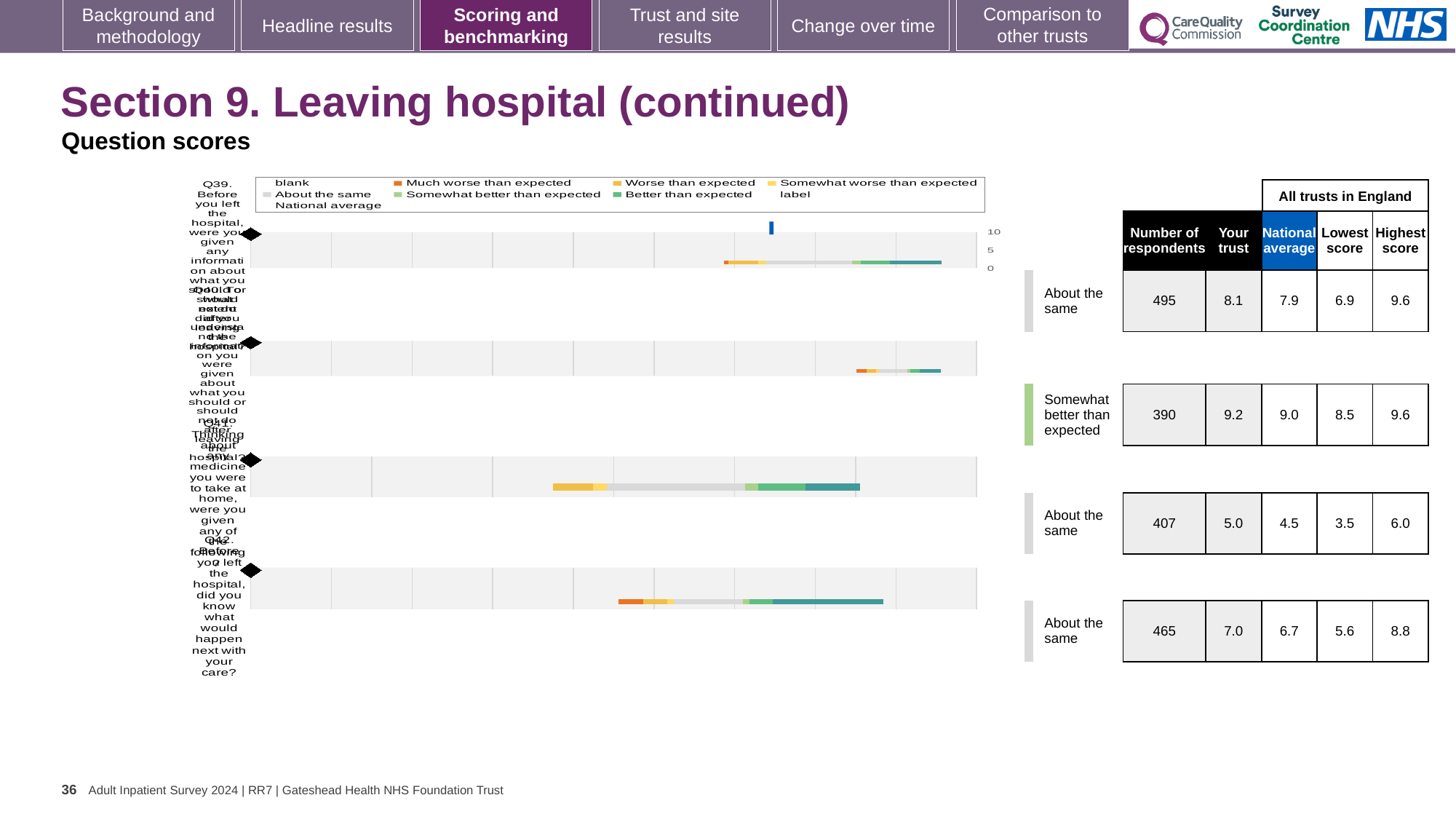
In the table beside the chart, which row has the highest 'Your trust' score? the second row (Q40), 9.2 In the chart legend, which colour represents 'Much worse than expected'? orange How many question rows (diamond markers) are plotted on the chart? 4 In the table beside the chart, what is the number of respondents for the second row (Q40)? 390 In the table beside the chart, which row has the lowest 'Your trust' score? the third row (Q41), 5.0 What kind of chart is shown on the slide? bar chart In the table beside the chart, for the fourth row (Q42), which is larger: 'Your trust' or 'National average'? Your trust In the table beside the chart, what is the 'Lowest score' for the fourth row (Q42)? 5.6 In the table beside the chart, what is the 'Your trust' score for the first row (Q39)? 8.1 In the table beside the chart, what is the 'Highest score' for the third row (Q41)? 6.0 In the table beside the chart, what is the difference between 'Your trust' and 'National average' for the first row (Q39)? 0.2 In the chart legend, what does the dark green entry represent? Better than expected